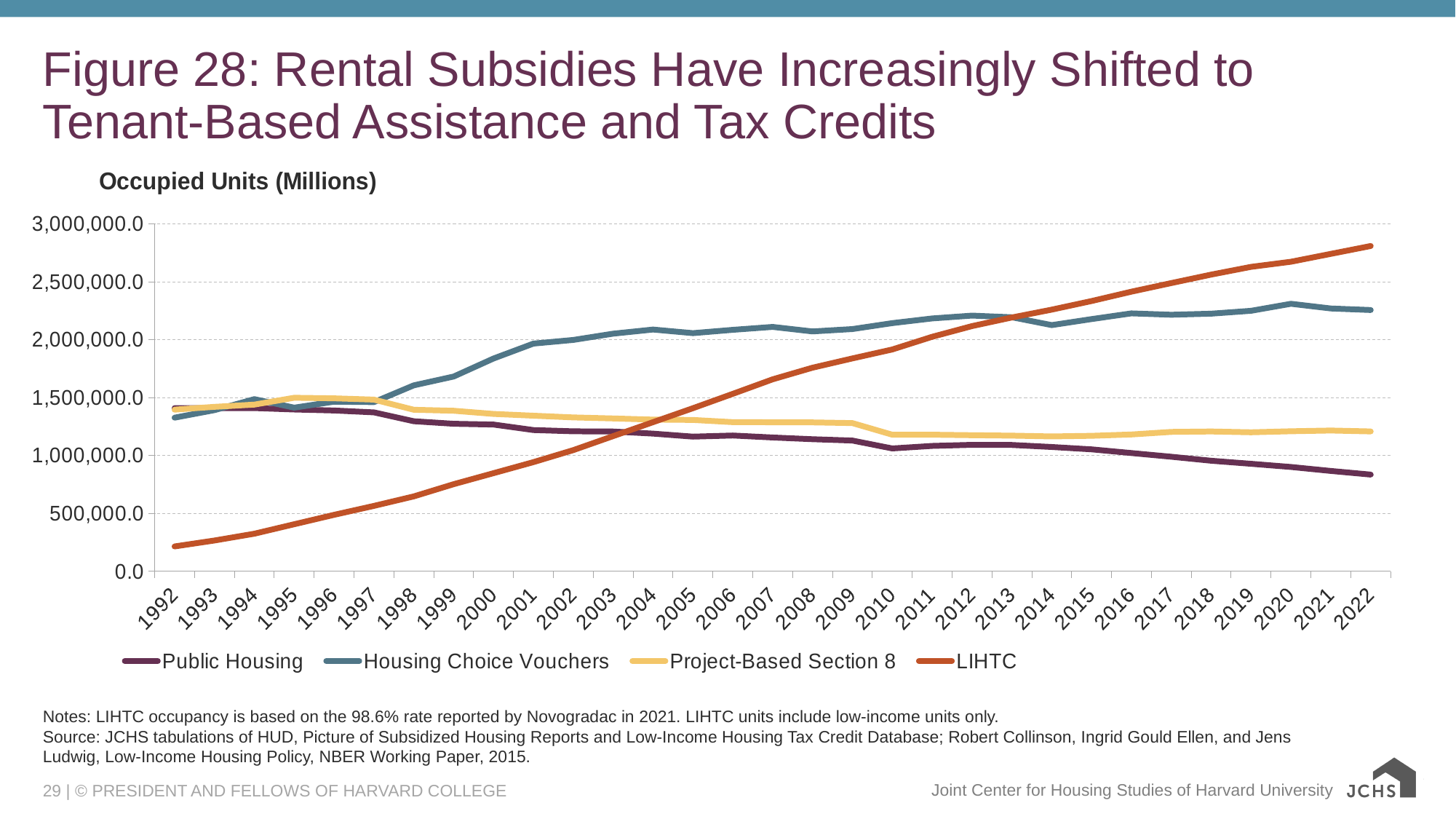
How many series does the legend list? 4 Does the LIHTC line rise or fall from 1992 to 2022? Rises What kind of chart is shown on the slide? Line chart Does the Public Housing line rise or fall from 1992 to 2022? Falls Is the value for LIHTC in 2022 greater or less than 2,500,000.0? greater In 2010, which is larger: Housing Choice Vouchers or Project-Based Section 8? Housing Choice Vouchers What is the label on the vertical axis of the chart? Occupied Units (Millions) Which series has the lowest value in 1992? LIHTC Which series has the highest value in 2022? LIHTC Is the value for Public Housing in 2022 greater or less than 1,000,000.0? less Which series has the lowest value in 2022? Public Housing How many years are plotted along the x axis? 31